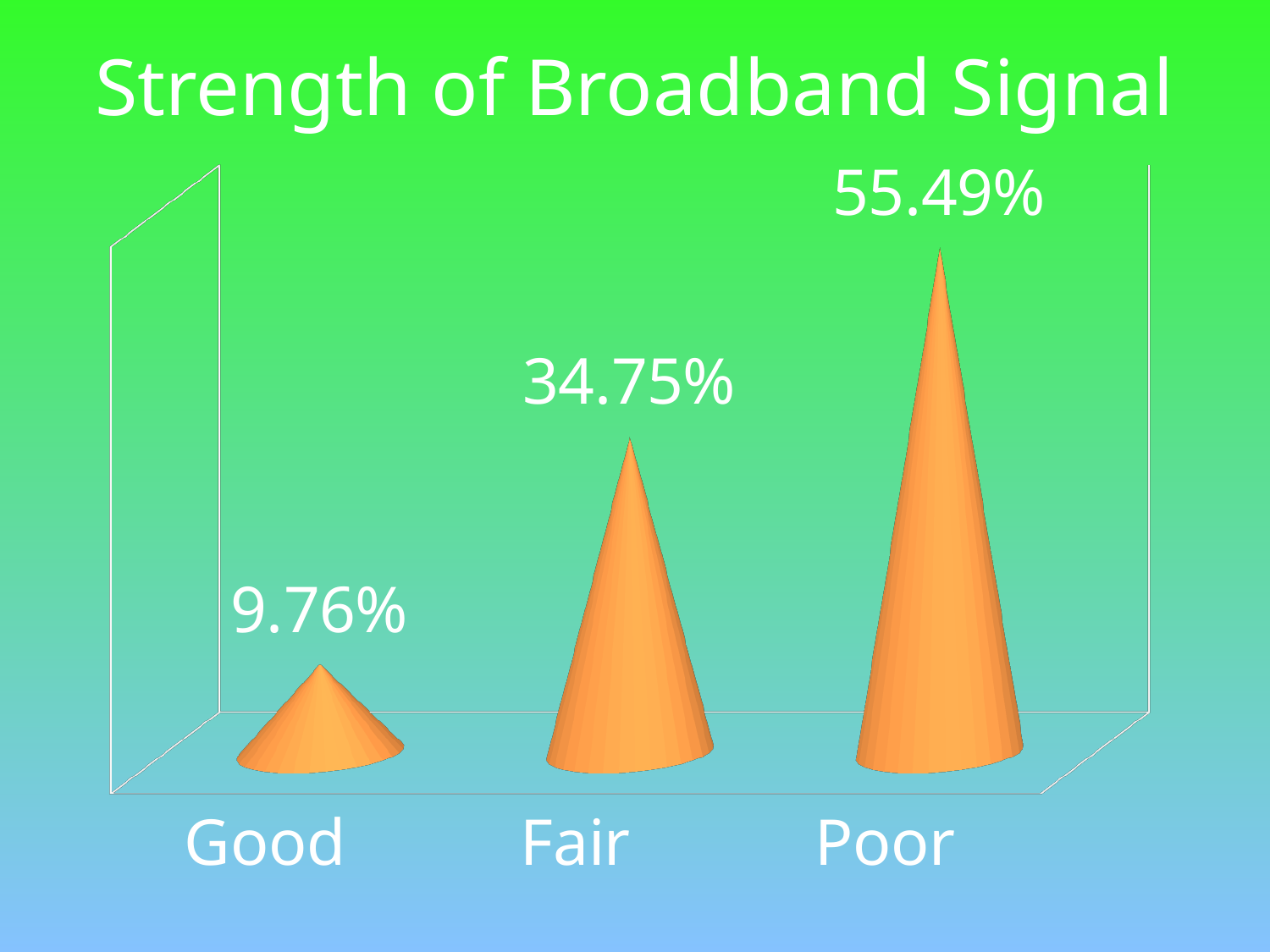
What kind of chart is shown on the slide? Bar chart Do the values rise or fall from Good to Poor along the x axis? Rise What is the value for Poor? 55.49% What is the difference between the values for Poor and Fair? 20.74% Which category has the lowest value? Good What is the difference between the values for Fair and Good? 24.99% What is the title of the chart? Strength of Broadband Signal Which category has the highest value? Poor What is the value for Good? 9.76% How many categories are shown on the chart? 3 What is the value for Fair? 34.75% Which is larger, the value for Fair or the value for Good? Fair